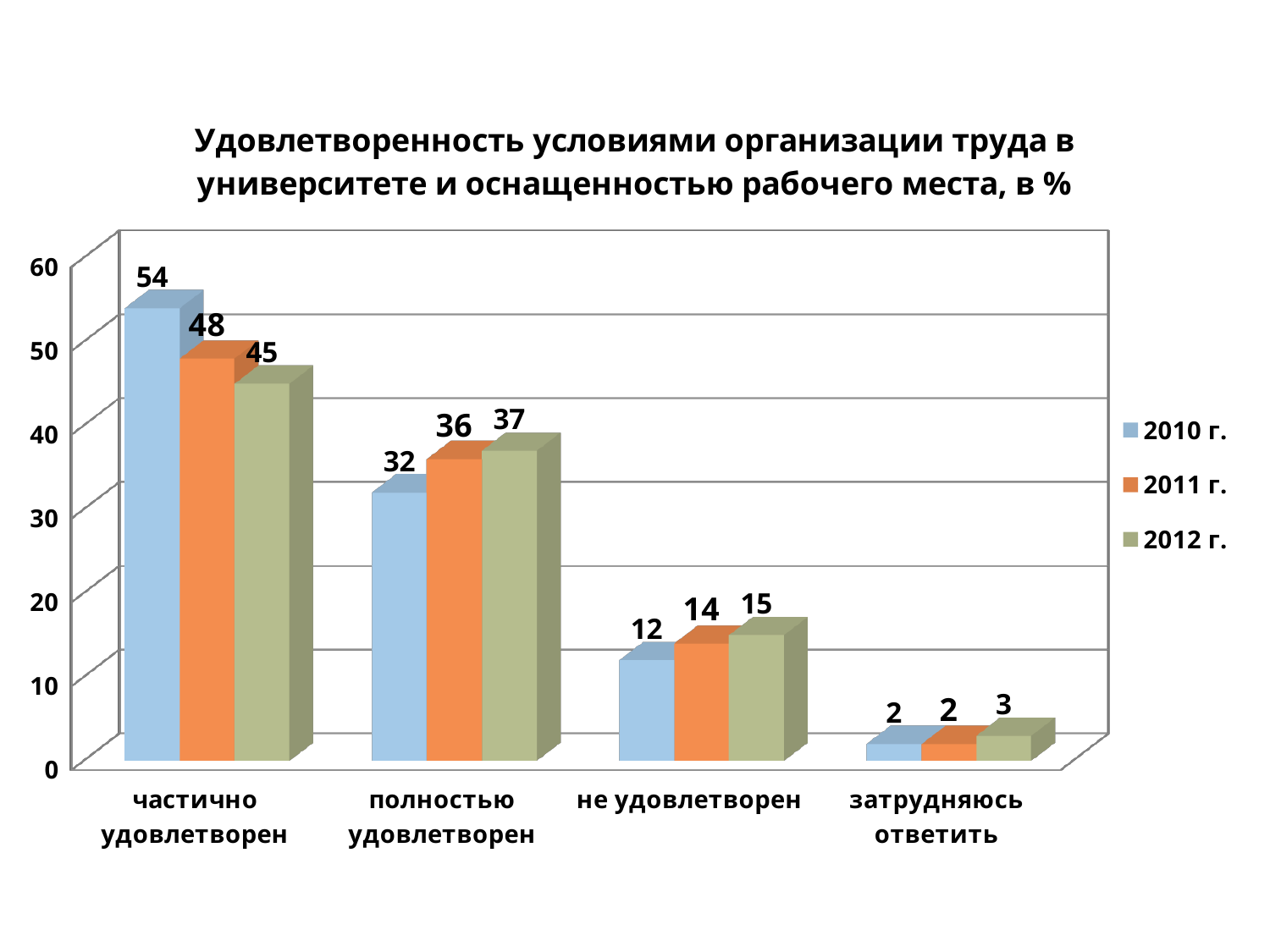
Which category has the lowest value in the 2012 г. series? затрудняюсь ответить What is the value for "частично удовлетворен" in the 2010 г. series? 54 How many categories are shown on the x axis? 4 Which series is shown in orange in the legend? 2011 г. What kind of chart is shown on the slide? bar chart How many series does the legend list? 3 What is the value for "не удовлетворен" in the 2011 г. series? 14 What is the difference between the 2010 г. and 2012 г. values for "частично удовлетворен"? 9 Which is larger for "полностью удовлетворен": the 2010 г. value or the 2011 г. value? 2011 г. What is the value for "полностью удовлетворен" in the 2012 г. series? 37 Which category has the highest value in the 2011 г. series? частично удовлетворен Do the values for the 2012 г. series rise or fall from "частично удовлетворен" to "затрудняюсь ответить"? fall